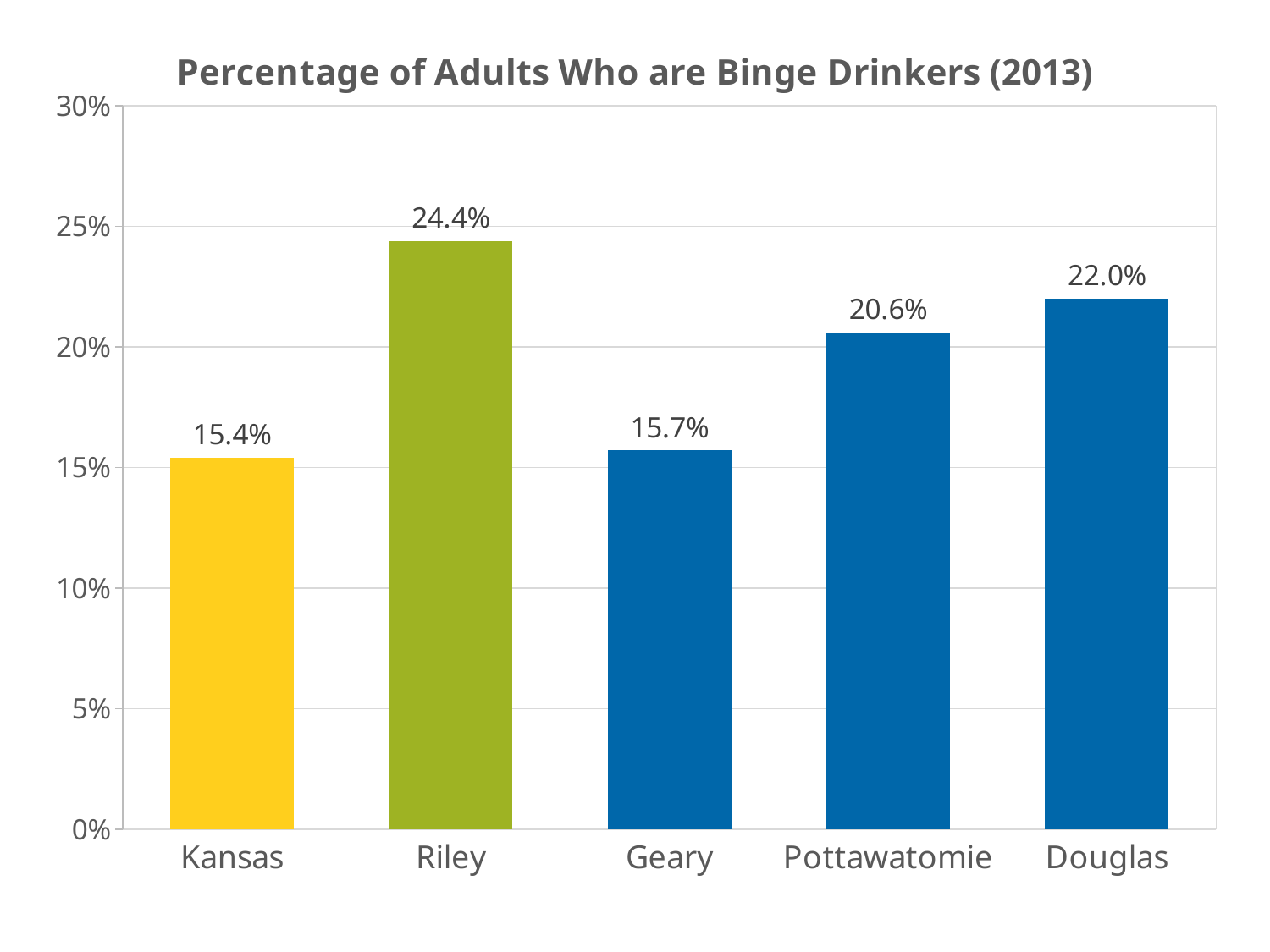
What is the difference between the values for Riley and Kansas? 9.0% What is the difference between the values for Douglas and Pottawatomie? 1.4% What kind of chart is shown on the slide? bar chart What is the percentage of adults who are binge drinkers in Kansas? 15.4% Which category has the highest percentage of adults who are binge drinkers? Riley What is the percentage of adults who are binge drinkers in Riley? 24.4% What is the value shown for Pottawatomie? 20.6% Is the value for Geary greater or less than 20%? less How many categories are shown on the x axis? 5 Which has a higher percentage of binge drinkers, Douglas or Geary? Douglas Which category has the lowest percentage of adults who are binge drinkers? Kansas What is the title of the chart? Percentage of Adults Who are Binge Drinkers (2013)